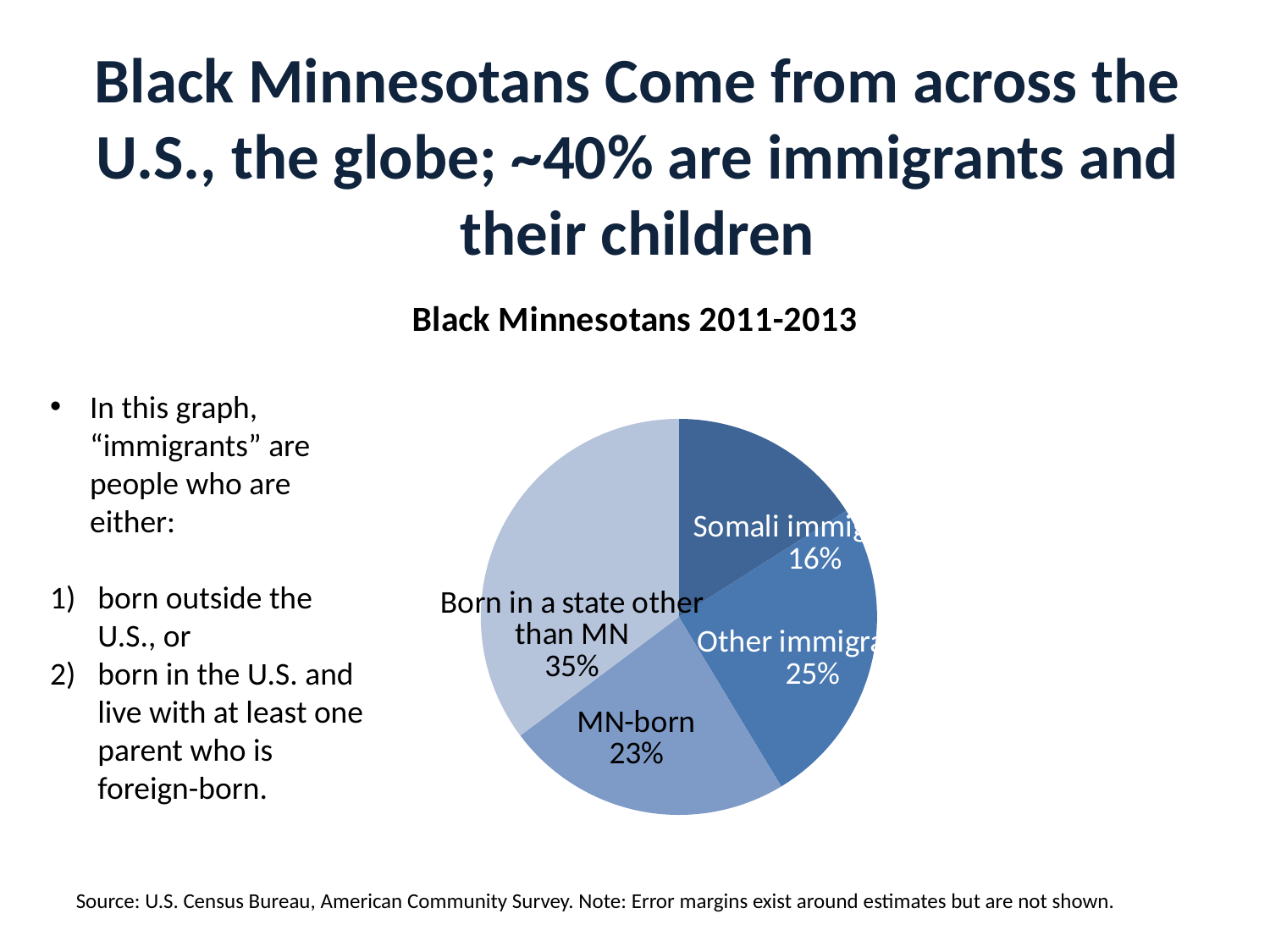
How many percentage points larger is the Born in a state other than MN slice than the MN-born slice? 12 percentage points Which slice of the pie is the smallest? Somali immigrants What share of the pie is MN-born? 23% Which slice of the pie is the largest? Born in a state other than MN What is the combined share of the Somali immigrants and Other immigrants slices? 41% What share of the pie is Other immigrants? 25% What kind of chart is shown on the slide? pie chart What is the title of the chart? Black Minnesotans 2011-2013 How many slices does the pie chart have? 4 What share of the pie is Born in a state other than MN? 35% What share of the pie is Somali immigrants? 16% Which is larger, the MN-born slice or the Other immigrants slice? Other immigrants